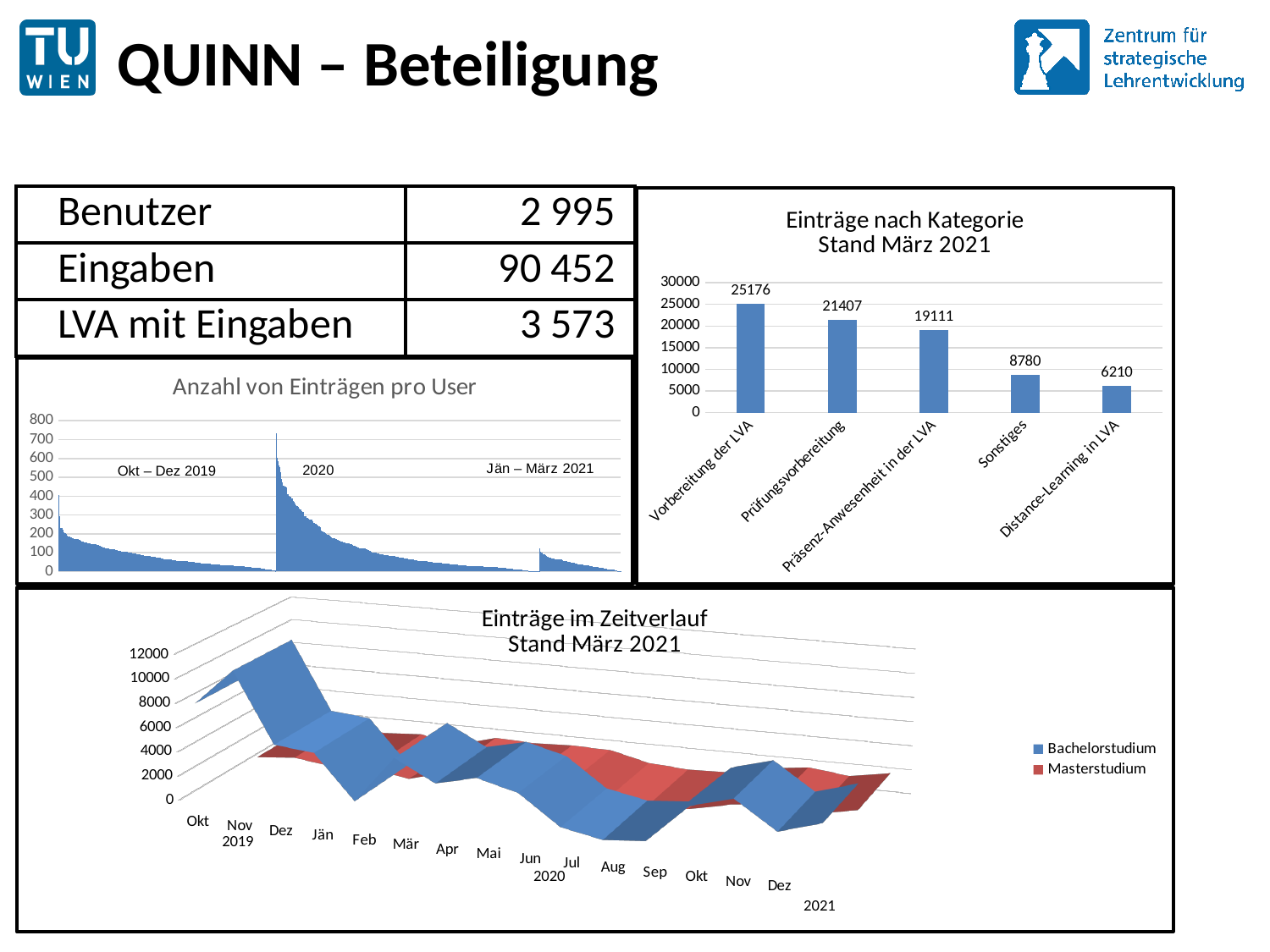
What are the legend entries of the 'Einträge im Zeitverlauf' chart? Bachelorstudium, Masterstudium In the 'Einträge nach Kategorie' chart, which is larger: Sonstiges or Distance-Learning in LVA? Sonstiges How many series does the legend of the 'Einträge im Zeitverlauf' chart list? 2 In the 'Einträge nach Kategorie' chart, what is the value for Vorbereitung der LVA? 25176 How many categories are shown in the 'Einträge nach Kategorie' chart? 5 In the 'Einträge nach Kategorie' chart, which category has the highest value? Vorbereitung der LVA In the 'Einträge nach Kategorie' chart, which category has the lowest value? Distance-Learning in LVA In the 'Einträge nach Kategorie' chart, what is the difference between Prüfungsvorbereitung and Präsenz-Anwesenheit in der LVA? 2296 In the 'Einträge nach Kategorie' chart, is the value for Präsenz-Anwesenheit in der LVA greater or less than 20000? less In the 'Einträge nach Kategorie' chart, what is the value for Sonstiges? 8780 What kind of chart is 'Einträge nach Kategorie'? bar chart In the 'Einträge nach Kategorie' chart, what is the difference between Vorbereitung der LVA and Distance-Learning in LVA? 18966